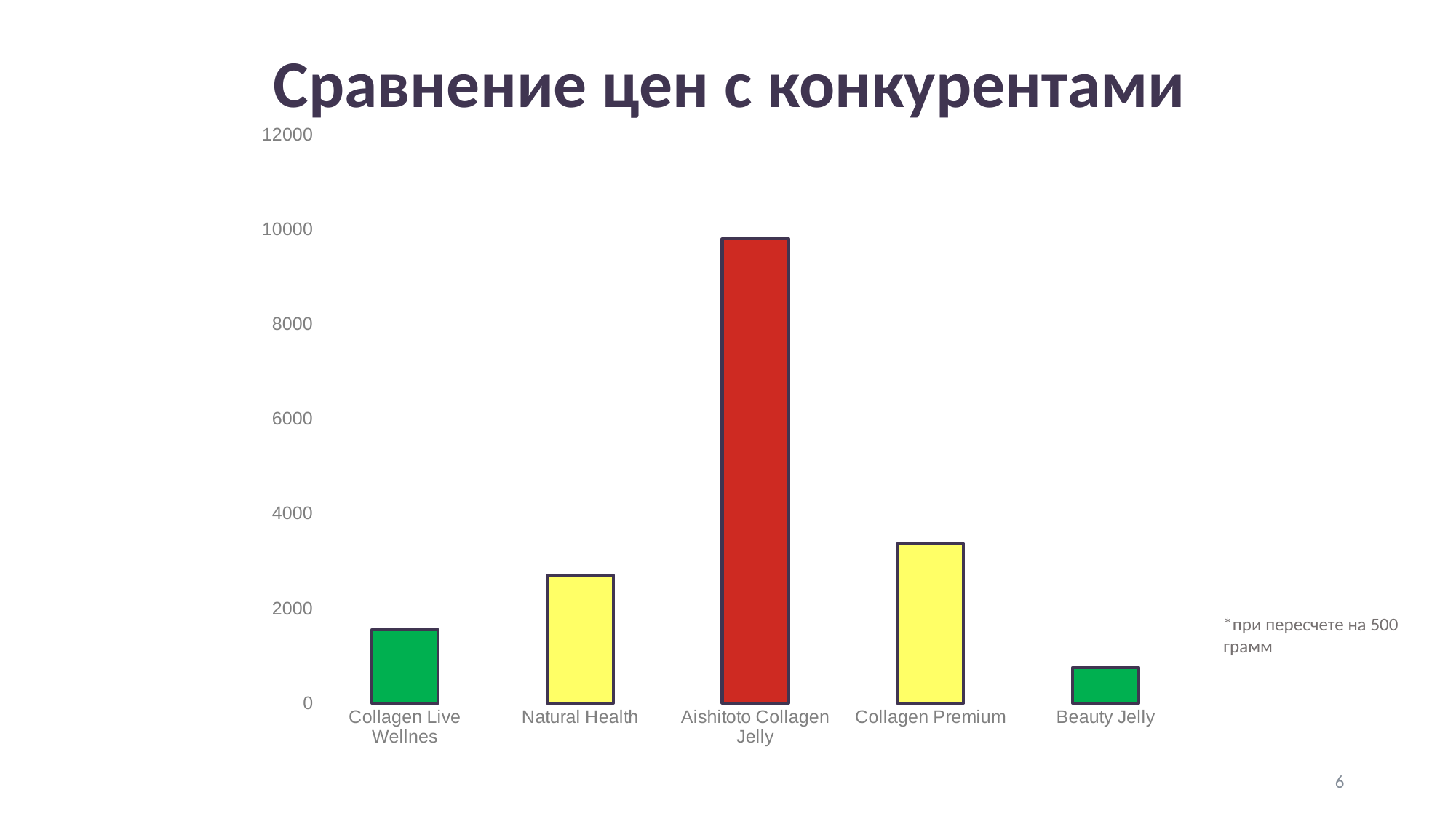
What kind of chart is shown on the slide? bar chart How many categories are shown on the x axis? 5 Is the value for Collagen Live Wellnes greater or less than 2000? less Which category has the lowest bar? Beauty Jelly Is the value for Natural Health greater or less than 2000? greater Is the value for Aishitoto Collagen Jelly greater or less than 8000? greater Which category has the highest bar? Aishitoto Collagen Jelly Which is larger, the value for Collagen Live Wellnes or the value for Beauty Jelly? Collagen Live Wellnes Which is larger, the value for Natural Health or the value for Collagen Premium? Collagen Premium What is the title of the slide? Сравнение цен с конкурентами